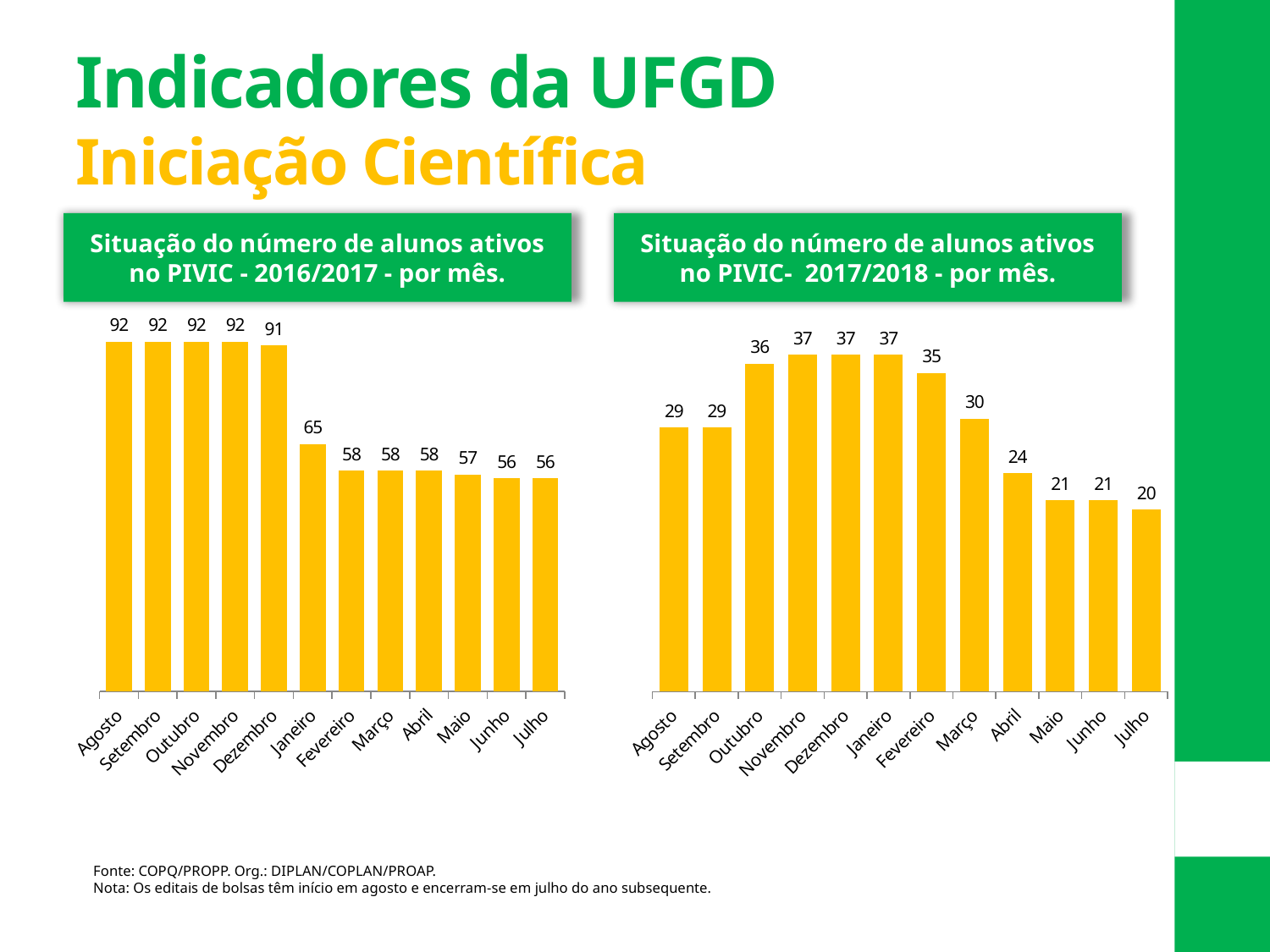
In the chart 'Situação do número de alunos ativos no PIVIC - 2016/2017 - por mês', what is the value for Maio? 57 In the chart 'Situação do número de alunos ativos no PIVIC- 2017/2018 - por mês', what is the value for Fevereiro? 35 In the chart 'Situação do número de alunos ativos no PIVIC- 2017/2018 - por mês', which month has the lowest value? Julho In the chart 'Situação do número de alunos ativos no PIVIC- 2017/2018 - por mês', what is the difference between the values for Outubro and Agosto? 7 What colour are the bars in the chart 'Situação do número de alunos ativos no PIVIC - 2016/2017 - por mês'? Yellow How many months are shown in the chart 'Situação do número de alunos ativos no PIVIC - 2016/2017 - por mês'? 12 In the chart 'Situação do número de alunos ativos no PIVIC - 2016/2017 - por mês', do the values rise or fall from Agosto to Julho? Fall In the chart 'Situação do número de alunos ativos no PIVIC- 2017/2018 - por mês', which is larger, the value for Março or the value for Abril? Março In the chart 'Situação do número de alunos ativos no PIVIC - 2016/2017 - por mês', what is the difference between the values for Dezembro and Janeiro? 26 What kind of chart is 'Situação do número de alunos ativos no PIVIC- 2017/2018 - por mês'? Bar chart In the chart 'Situação do número de alunos ativos no PIVIC - 2016/2017 - por mês', what is the value for Janeiro? 65 In the chart 'Situação do número de alunos ativos no PIVIC- 2017/2018 - por mês', what is the value for Abril? 24